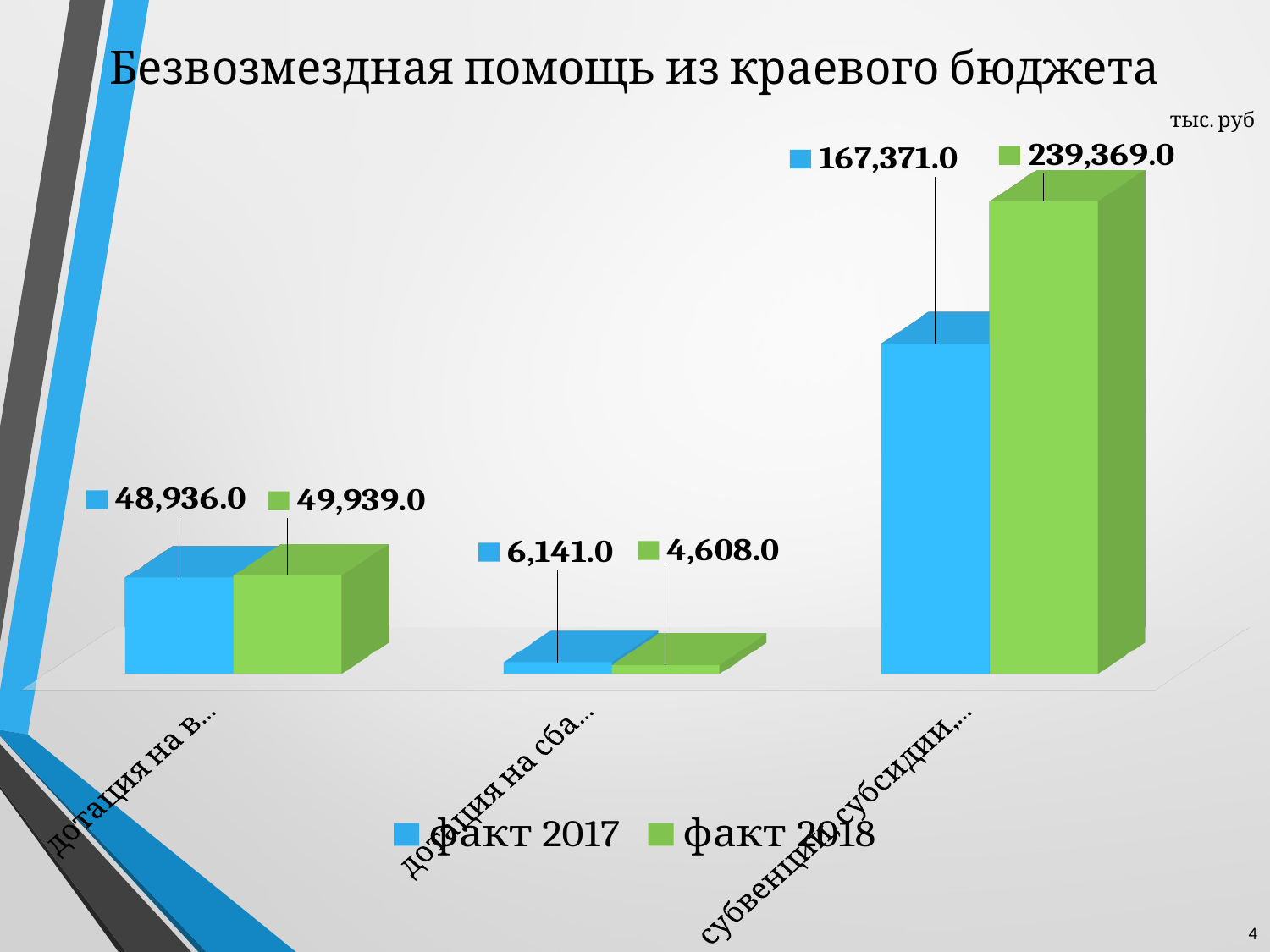
What kind of chart is shown on the slide? bar chart How many series does the legend list? 2 What is the value of факт 2018 for the third category (субвенции, субсидии,...)? 239,369.0 Which category has the lowest value for факт 2017? дотация на сба... (the second category) How many categories are plotted along the x axis? 3 By how much does факт 2018 exceed факт 2017 for the third category (субвенции, субсидии,...)? 71,998.0 What is the value of факт 2017 for the first category (дотация на в...)? 48,936.0 Which category has the highest value for факт 2018? субвенции, субсидии,... (the third category) For the second category (дотация на сба...), which is larger: факт 2017 or факт 2018? факт 2017 What is the value of факт 2017 for the third category (субвенции, субсидии,...)? 167,371.0 What is the value of факт 2018 for the second category (дотация на сба...)? 4,608.0 What unit is indicated for the values in the chart? тыс. руб